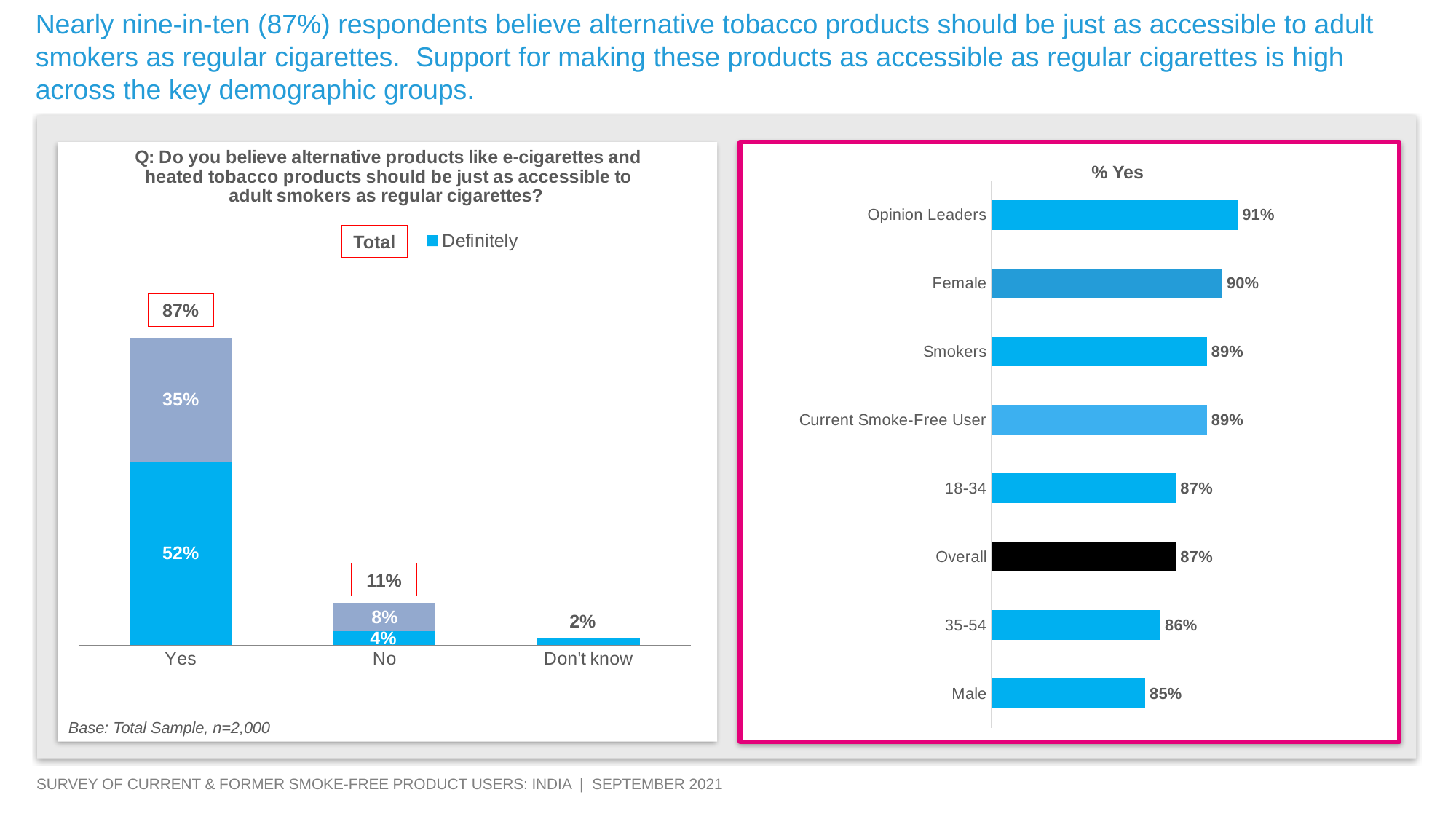
In the left chart, how many categories are shown on the x axis? 3 In the '% Yes' chart on the right, which group has the highest value? Opinion Leaders In the '% Yes' chart on the right, how many groups are listed? 8 In the '% Yes' chart on the right, what is the difference between Opinion Leaders and Male? 6% What kind of chart is the '% Yes' chart on the right? Bar chart In the '% Yes' chart on the right, which group has the lowest value? Male In the left chart, what is the value for 'Don't know'? 2% In the '% Yes' chart on the right, what is the value for Female? 90% In the left chart, what is the total percentage for the 'Yes' bar? 87% In the left chart, what is the difference between the 'Yes' total and the 'No' total? 76% In the left chart, what is the 'Definitely' value for 'Yes'? 52% In the left chart, what is the total percentage for the 'No' bar? 11%